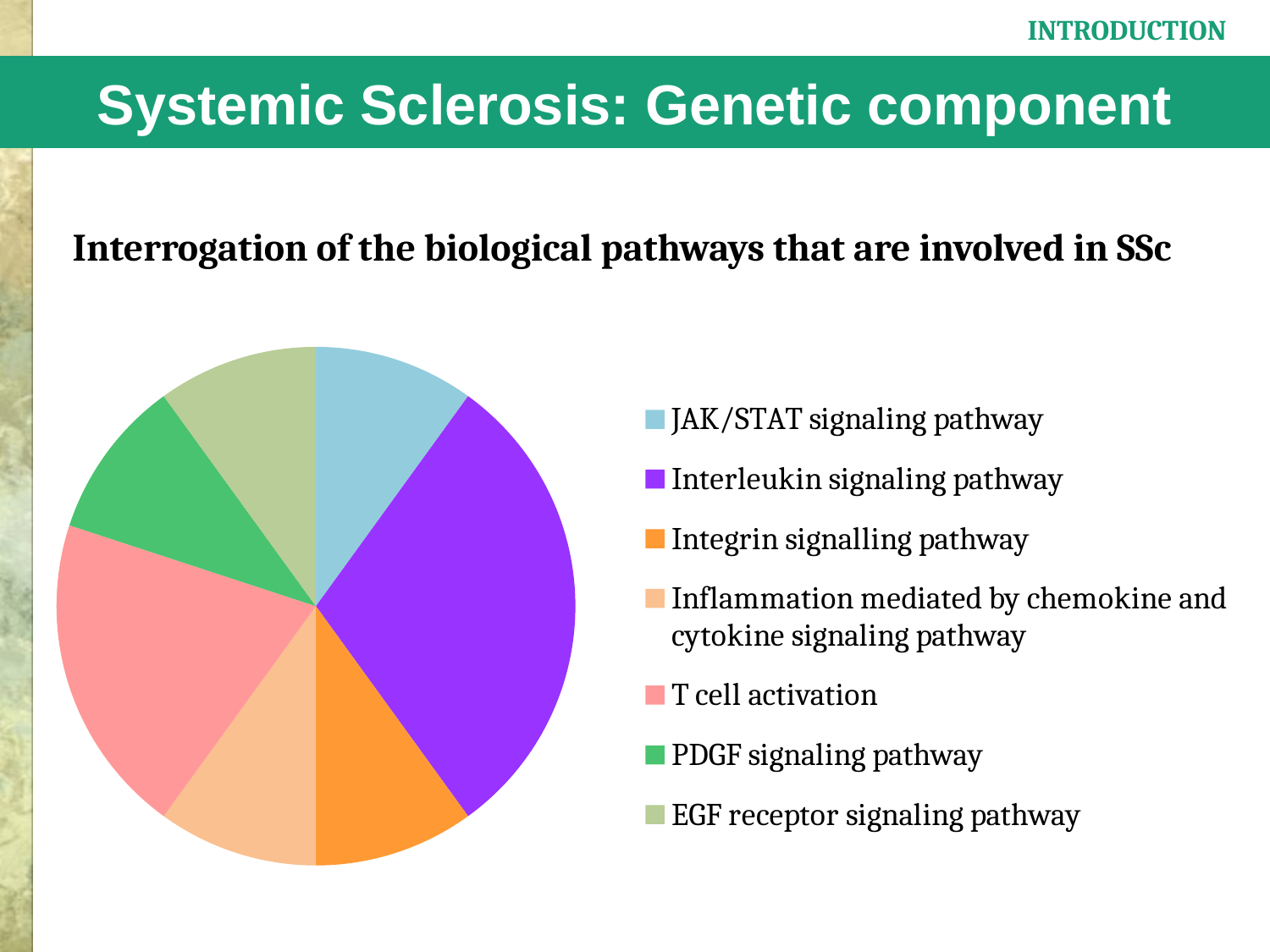
Which slice is larger: T cell activation or PDGF signaling pathway? T cell activation Which slice is larger: Interleukin signaling pathway or T cell activation? Interleukin signaling pathway Which pathway has the largest slice in the pie chart? Interleukin signaling pathway How many entries does the legend of the pie chart list? 7 Which slice is larger: T cell activation or EGF receptor signaling pathway? T cell activation Which pathway is shown in orange in the pie chart? Integrin signalling pathway How many slices does the pie chart have? 7 Which pathway has the second-largest slice in the pie chart? T cell activation What kind of chart is shown on the slide? pie chart Which colour represents the Interleukin signaling pathway in the pie chart? purple